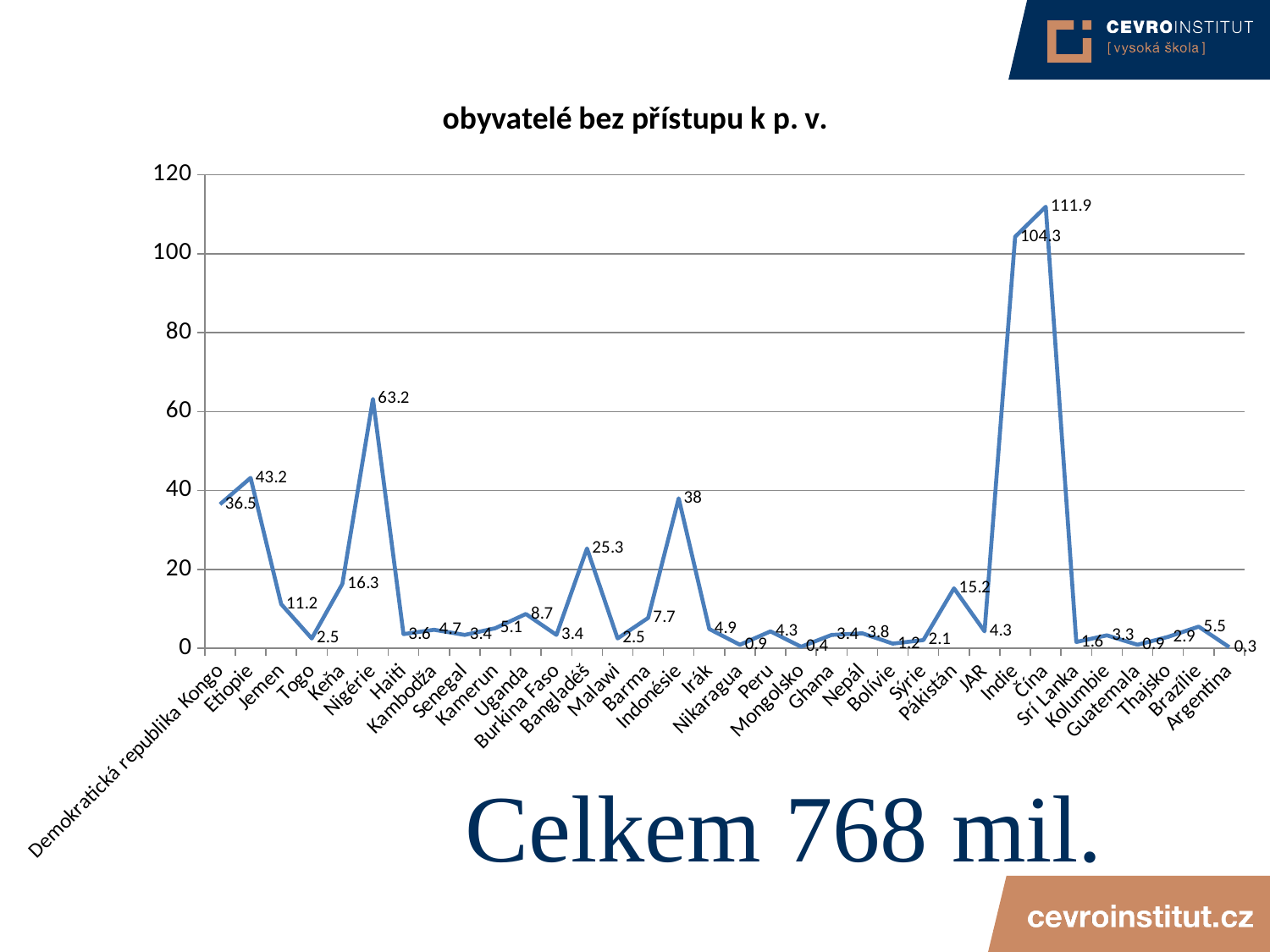
Which country has the highest value? Čína What is the value for Pákistán? 15.2 What is the value for Bangladéš? 25.3 Which country has the lowest value? Argentina What is the difference between the values for Čína and Indie? 7.6 What is the value for Indie? 104.3 What is the value for Nigérie? 63.2 How many countries are plotted on the chart? 34 What is the difference between the values for Nigérie and Etiopie? 20 What type of chart is shown on the slide? line chart What is the title of the chart? obyvatelé bez přístupu k p. v. Which has a larger value, Indonésie or Etiopie? Etiopie